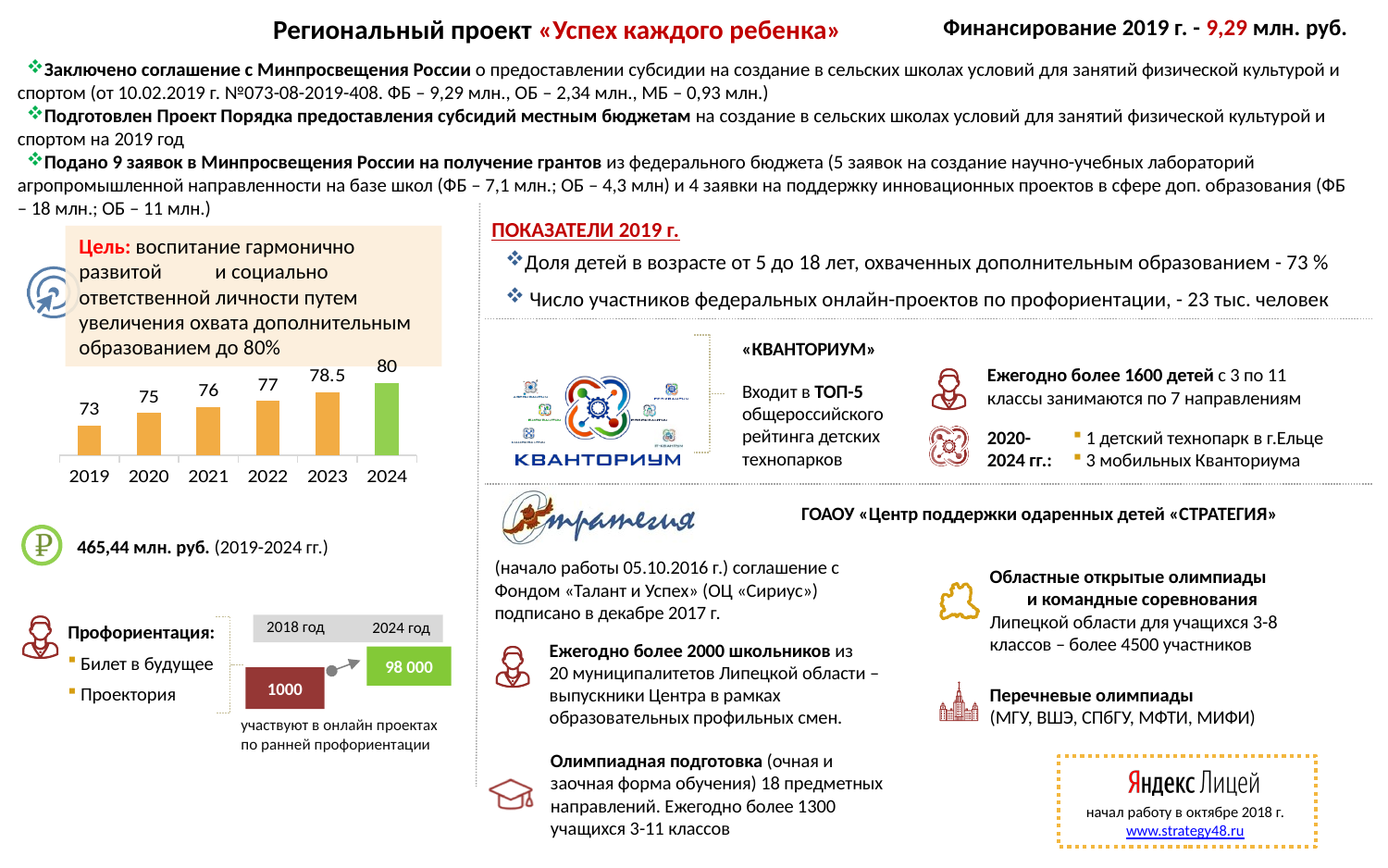
In the bar chart on the left of the slide, what is the value for 2019? 73 In the bar chart on the left of the slide, what is the value for 2024? 80 In the bar chart on the left of the slide, what is the value for 2023? 78.5 What kind of chart is shown on the left of the slide below the 'Цель' box? bar chart How many bars are shown in the bar chart on the left of the slide? 6 In the bar chart on the left of the slide, what is the difference between the values for 2023 and 2022? 1.5 In the bar chart on the left of the slide, do the values rise or fall from 2019 to 2024? rise In the bar chart on the left of the slide, which is larger, the value for 2021 or the value for 2020? 2021 In the bar chart on the left of the slide, which bar is coloured differently (green) from the others? 2024 In the bar chart on the left of the slide, which year has the lowest value? 2019 In the bar chart on the left of the slide, which year has the highest value? 2024 In the bar chart on the left of the slide, what is the difference between the values for 2024 and 2019? 7